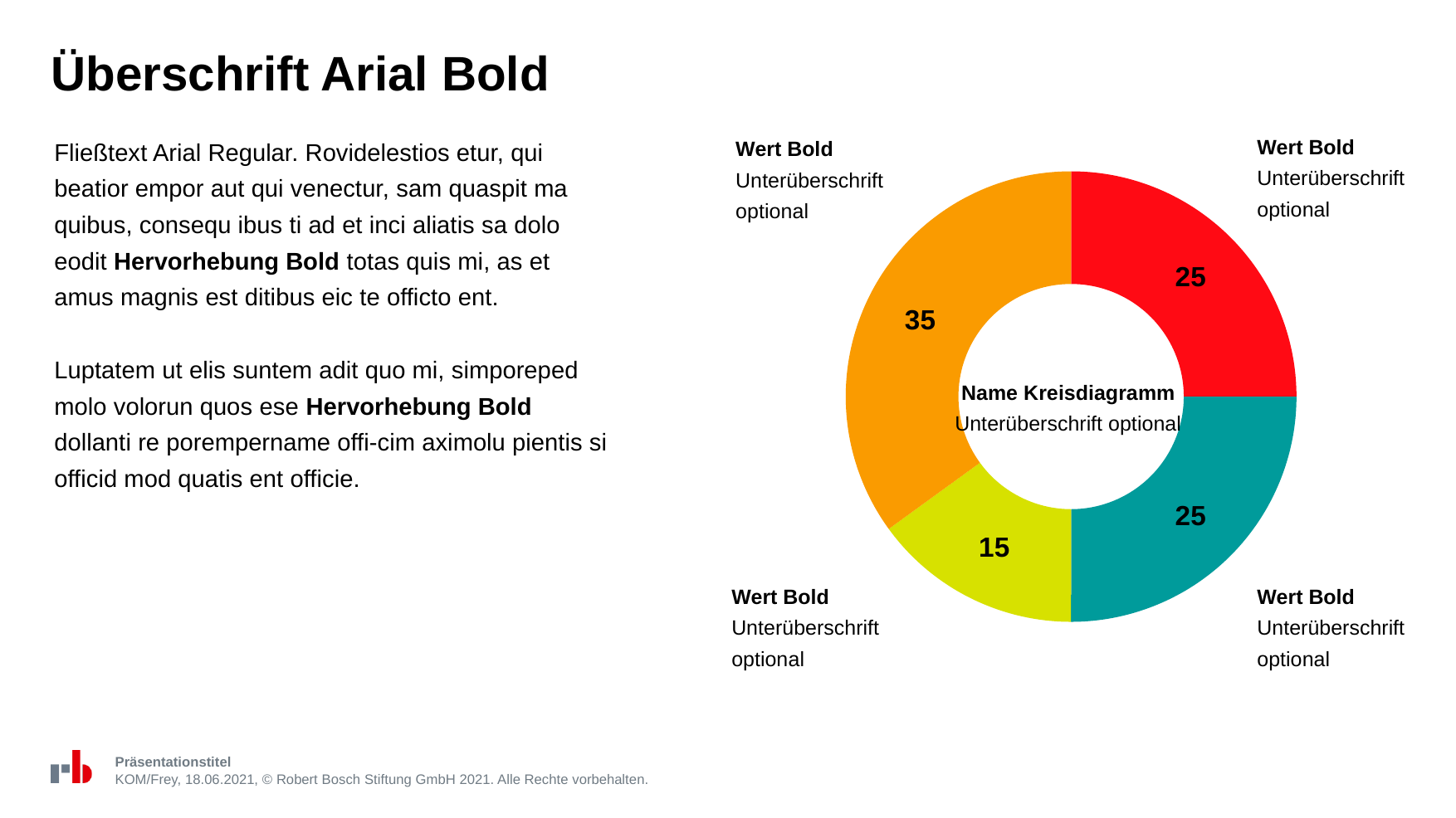
What is the total of all the values printed on the donut chart? 100 Which slice of the donut chart has the largest value? The orange slice (35) How many slices does the donut chart have? 4 What value is printed on the yellow-green slice of the donut chart? 15 What is the difference between the orange slice's value and the yellow-green slice's value? 20 Which slice of the donut chart has the smallest value? The yellow-green slice (15) What value is printed on the red slice of the donut chart? 25 Which is larger, the value of the orange slice or the value of the red slice? The orange slice What value is printed on the orange slice of the donut chart? 35 What kind of chart is shown on the slide? Pie chart (donut) What title is printed in the centre of the donut chart? Name Kreisdiagramm What value is printed on the teal slice of the donut chart? 25